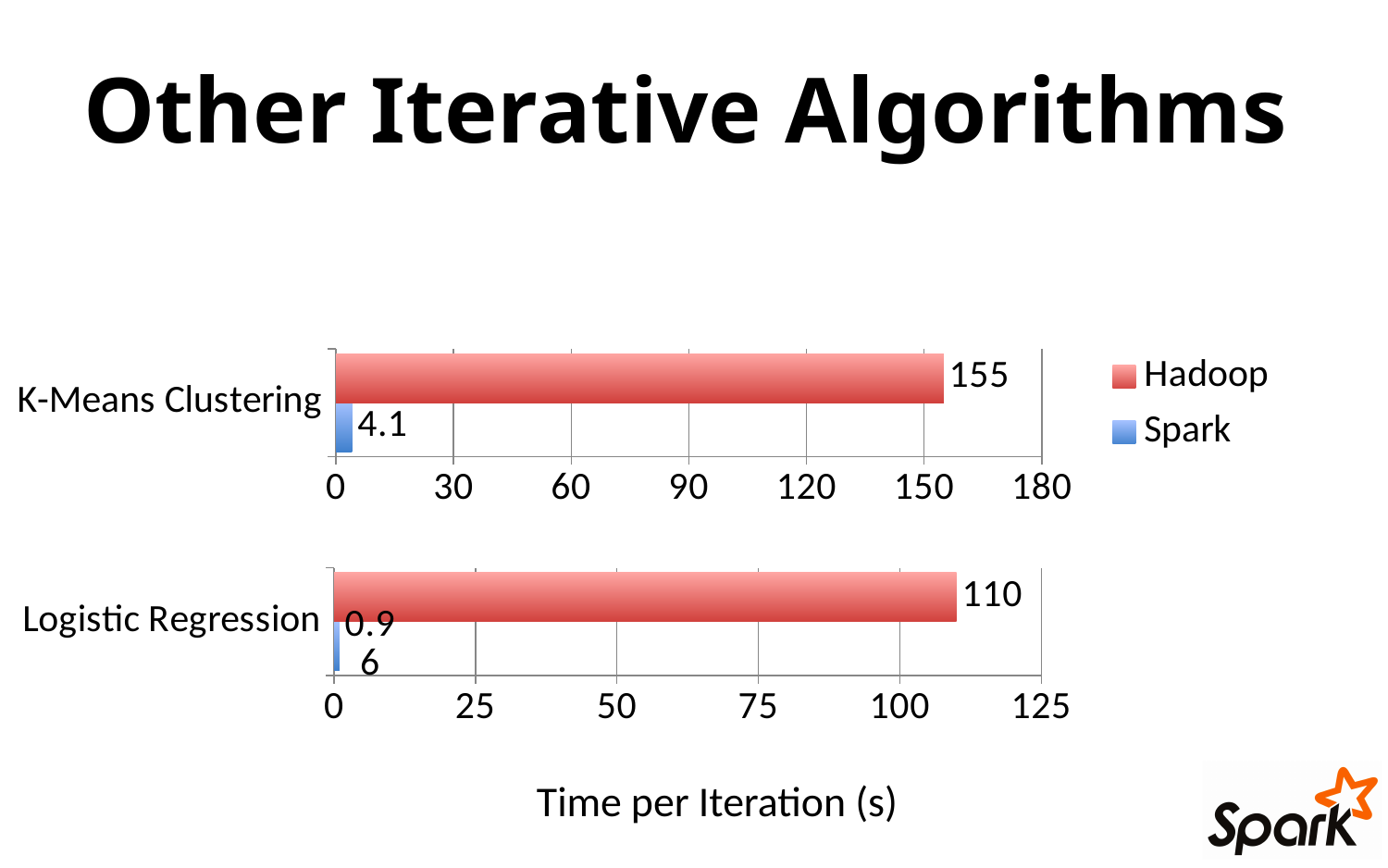
In the top chart (K-Means Clustering), is the value for Hadoop greater or less than 120? greater In the top chart (K-Means Clustering), what is the difference between the Hadoop and Spark values? 150.9 How many series does the legend list? 2 In the top chart (K-Means Clustering), which series has the larger value, Hadoop or Spark? Hadoop What kind of chart is used on this slide? Bar chart In the bottom chart (Logistic Regression), is the value for Spark greater or less than 25? less In the bottom chart (Logistic Regression), which series has the larger value, Hadoop or Spark? Hadoop In the top chart (K-Means Clustering), what is the time per iteration for Hadoop? 155 What colour represents Hadoop in the legend? Red In the bottom chart (Logistic Regression), what is the time per iteration for Hadoop? 110 What is the label on the horizontal axis shared by the charts? Time per Iteration (s) In the top chart (K-Means Clustering), what is the time per iteration for Spark? 4.1